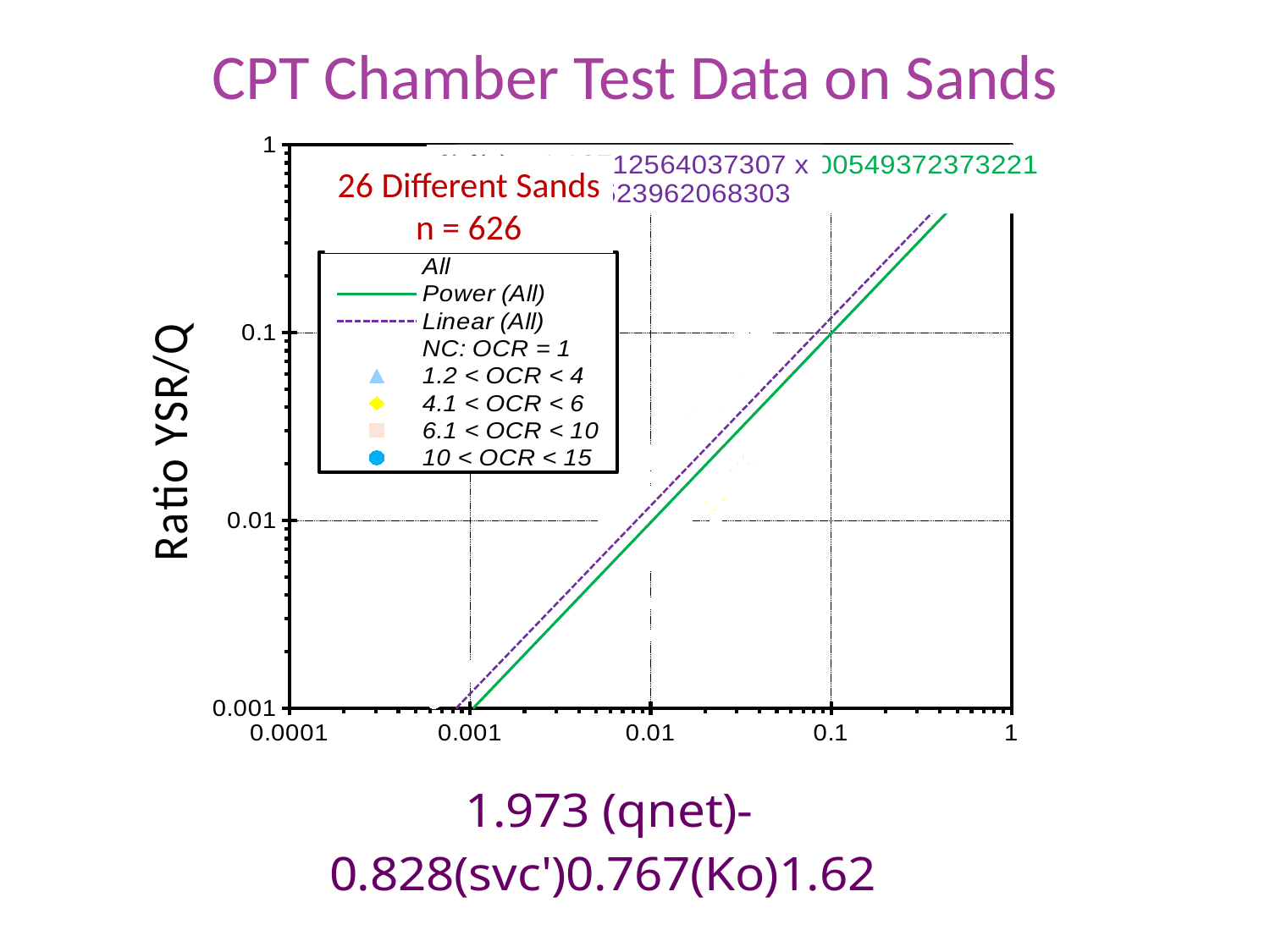
What is the label on the y-axis of the chart? Ratio YSR/Q What is the title of the slide's chart? CPT Chamber Test Data on Sands What kind of chart is shown on the slide? scatter chart How many entries does the chart legend list? 8 Do the trendlines rise or fall as the x-axis value increases? rise